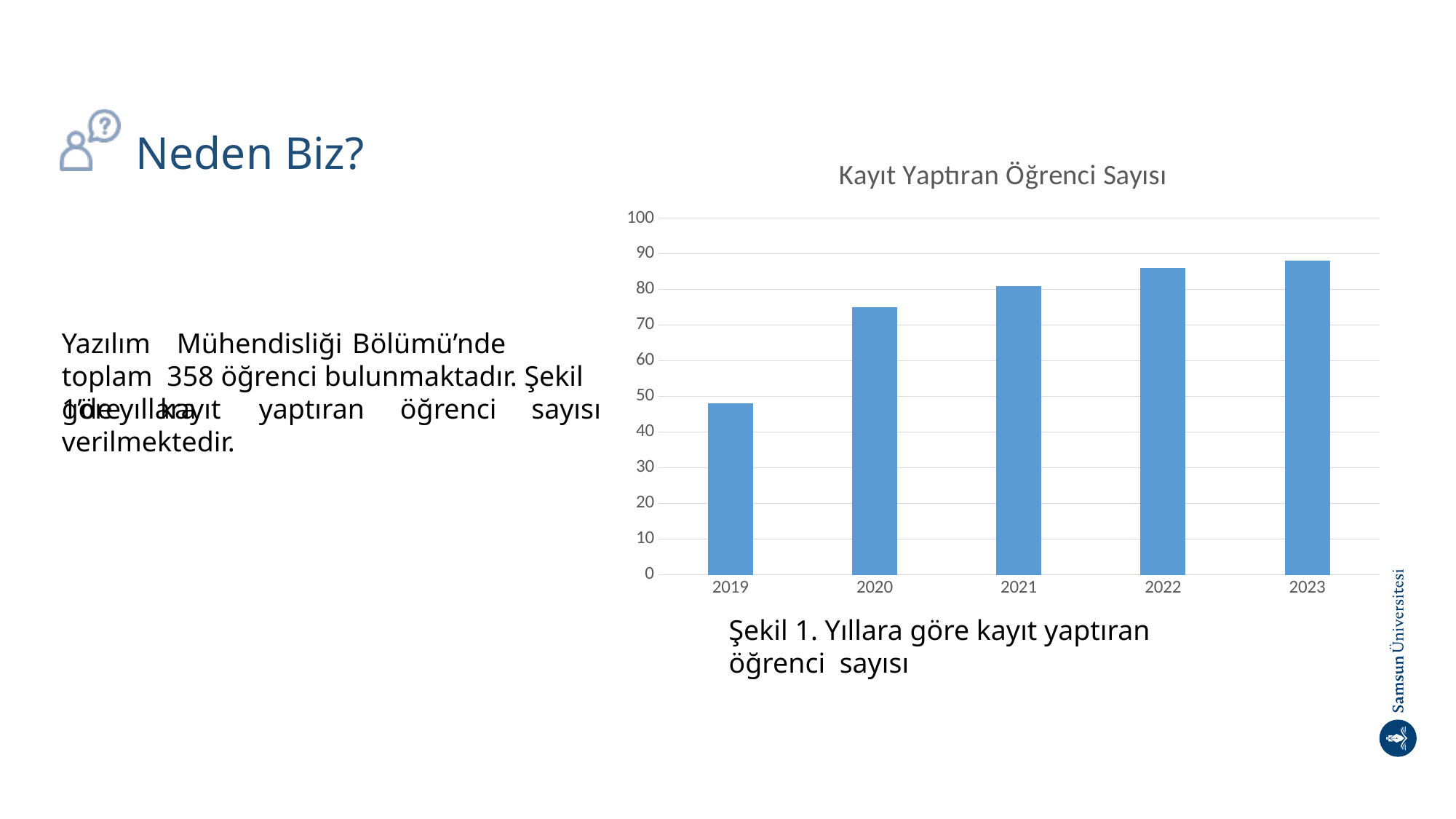
Which year has the lowest number of registered students? 2019 How many years are shown on the x axis of the chart? 5 Is the value for 2021 greater or less than 90? less What is the title of the chart? Kayıt Yaptıran Öğrenci Sayısı Which is larger, the value for 2021 or the value for 2019? 2021 Which is larger, the value for 2019 or the value for 2020? 2020 Is the value for 2022 greater or less than 80? greater Is the value for 2019 greater or less than 50? less Do the values rise or fall from 2019 to 2023? rise What kind of chart is shown on the slide? bar chart